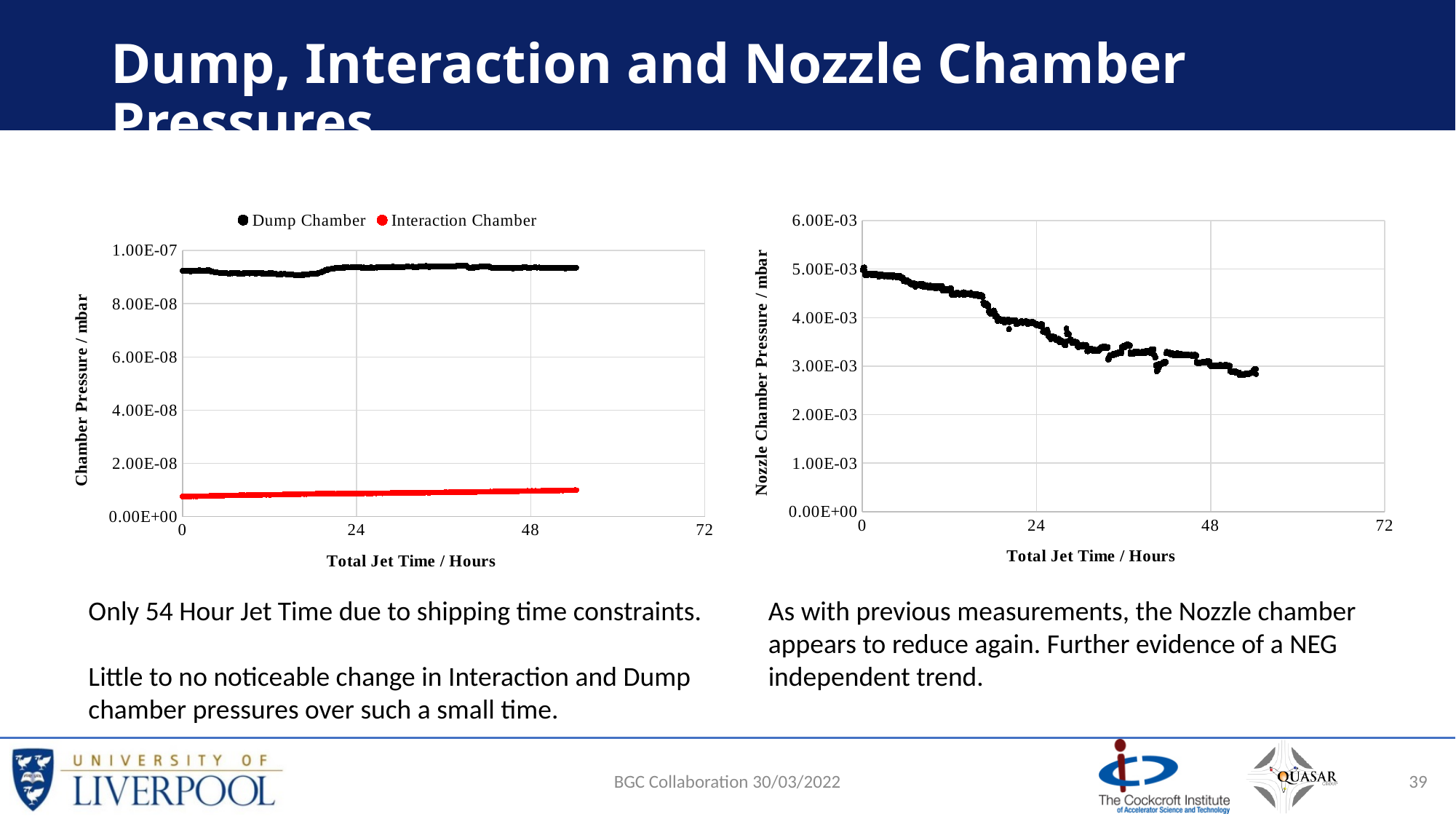
What kind of chart is the right chart? Scatter chart On the left chart, is the Dump Chamber pressure greater or less than 8.00E-08 mbar? greater On the left chart, is the Interaction Chamber pressure greater or less than 2.00E-08 mbar? less On the right chart, what is the highest value shown on the y axis? 6.00E-03 What is the x-axis label on the right chart? Total Jet Time / Hours On the right chart, does the Nozzle Chamber pressure rise or fall as Total Jet Time increases? fall On the left chart, what colour are the Interaction Chamber points? Red On the right chart, is the Nozzle Chamber pressure at 0 hours greater or less than 4.00E-03 mbar? greater On the left chart, which series has the higher pressure, Dump Chamber or Interaction Chamber? Dump Chamber On the left chart, how many series does the legend list? 2